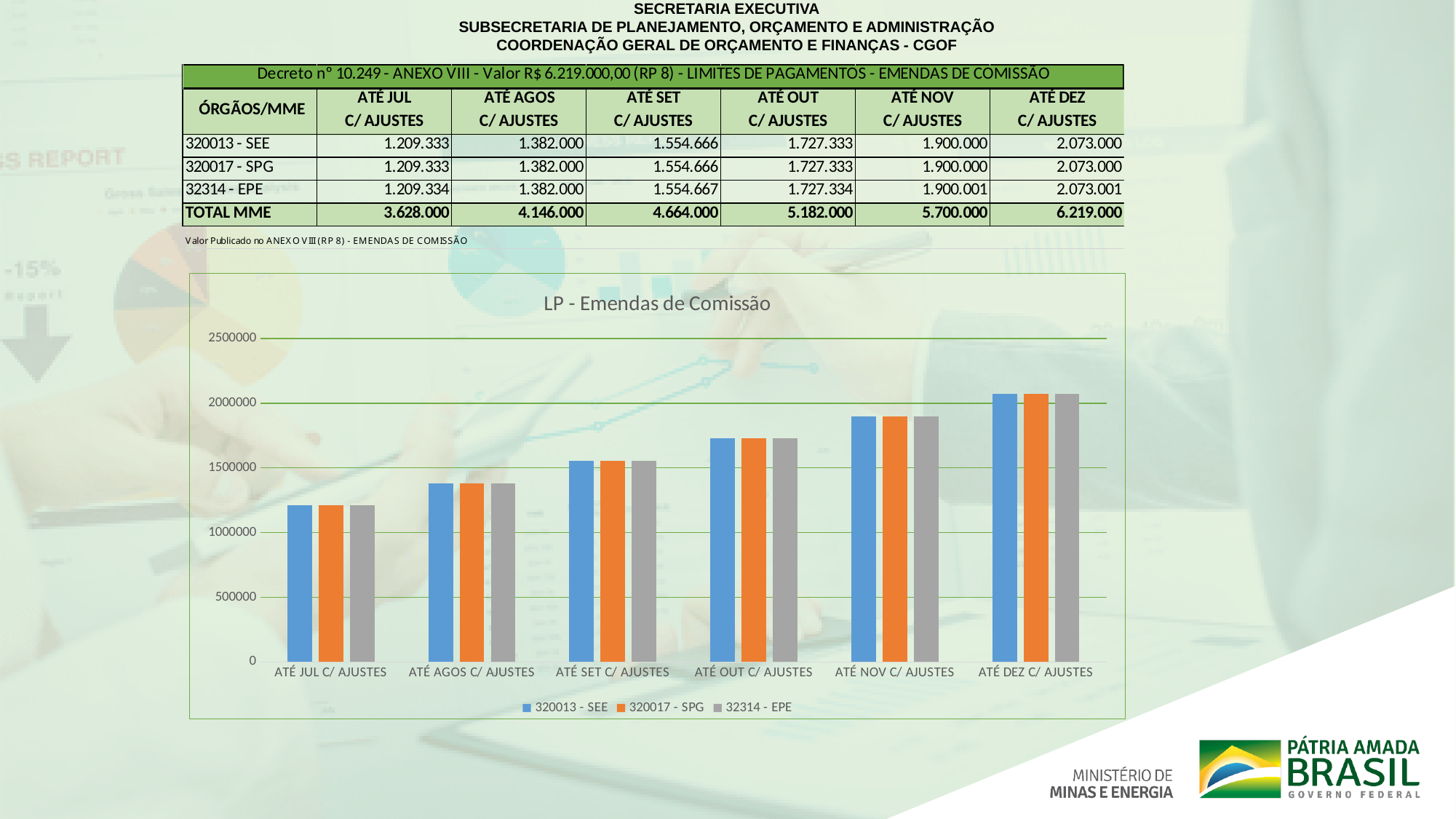
What kind of chart is "LP - Emendas de Comissão"? bar chart According to the table on the slide, what is the value for 32314 - EPE at ATÉ DEZ C/ AJUSTES? 2.073.001 In the "LP - Emendas de Comissão" chart, which category has the lowest value for 32314 - EPE? ATÉ JUL C/ AJUSTES In the "LP - Emendas de Comissão" chart, is the value for 320013 - SEE at ATÉ JUL C/ AJUSTES greater or less than 1500000? less In the "LP - Emendas de Comissão" chart, which category has the highest value for 320013 - SEE? ATÉ DEZ C/ AJUSTES In the "LP - Emendas de Comissão" chart, do the values for 320013 - SEE rise or fall from ATÉ JUL C/ AJUSTES to ATÉ DEZ C/ AJUSTES? rise In the "LP - Emendas de Comissão" chart, is the value for 320017 - SPG at ATÉ DEZ C/ AJUSTES greater or less than 2000000? greater How many categories are shown on the x axis of the "LP - Emendas de Comissão" chart? 6 In the "LP - Emendas de Comissão" chart, is the value for 32314 - EPE at ATÉ OUT C/ AJUSTES greater or less than 1500000? greater How many series does the legend of the "LP - Emendas de Comissão" chart list? 3 According to the table on the slide, what is the value for 320013 - SEE at ATÉ JUL C/ AJUSTES? 1.209.333 What is the title of the chart on the slide? LP - Emendas de Comissão